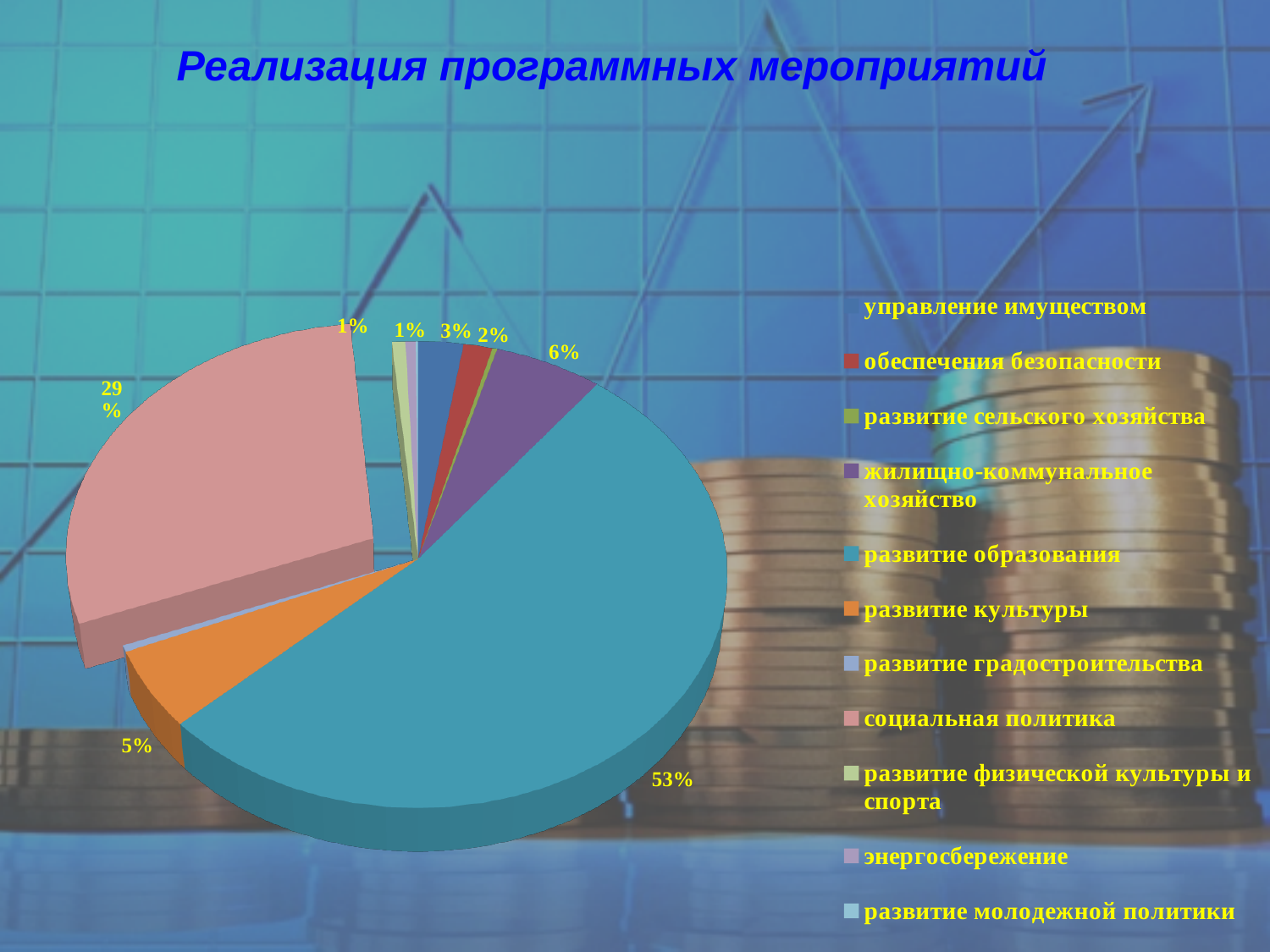
Which category has the largest share of the pie? развитие образования Which is larger, the share for жилищно-коммунальное хозяйство or the share for развитие культуры? жилищно-коммунальное хозяйство What kind of chart is shown on the slide? pie chart What share of the pie does развитие образования have? 53% What share of the pie does жилищно-коммунальное хозяйство have? 6% By how many percentage points does the share for развитие образования exceed the share for социальная политика? 24 How many categories does the legend of the pie chart list? 11 What is the title of the chart on the slide? Реализация программных мероприятий What share of the pie does развитие культуры have? 5% Which is larger, the share for развитие образования or the share for социальная политика? развитие образования What colour is the slice for развитие образования? teal